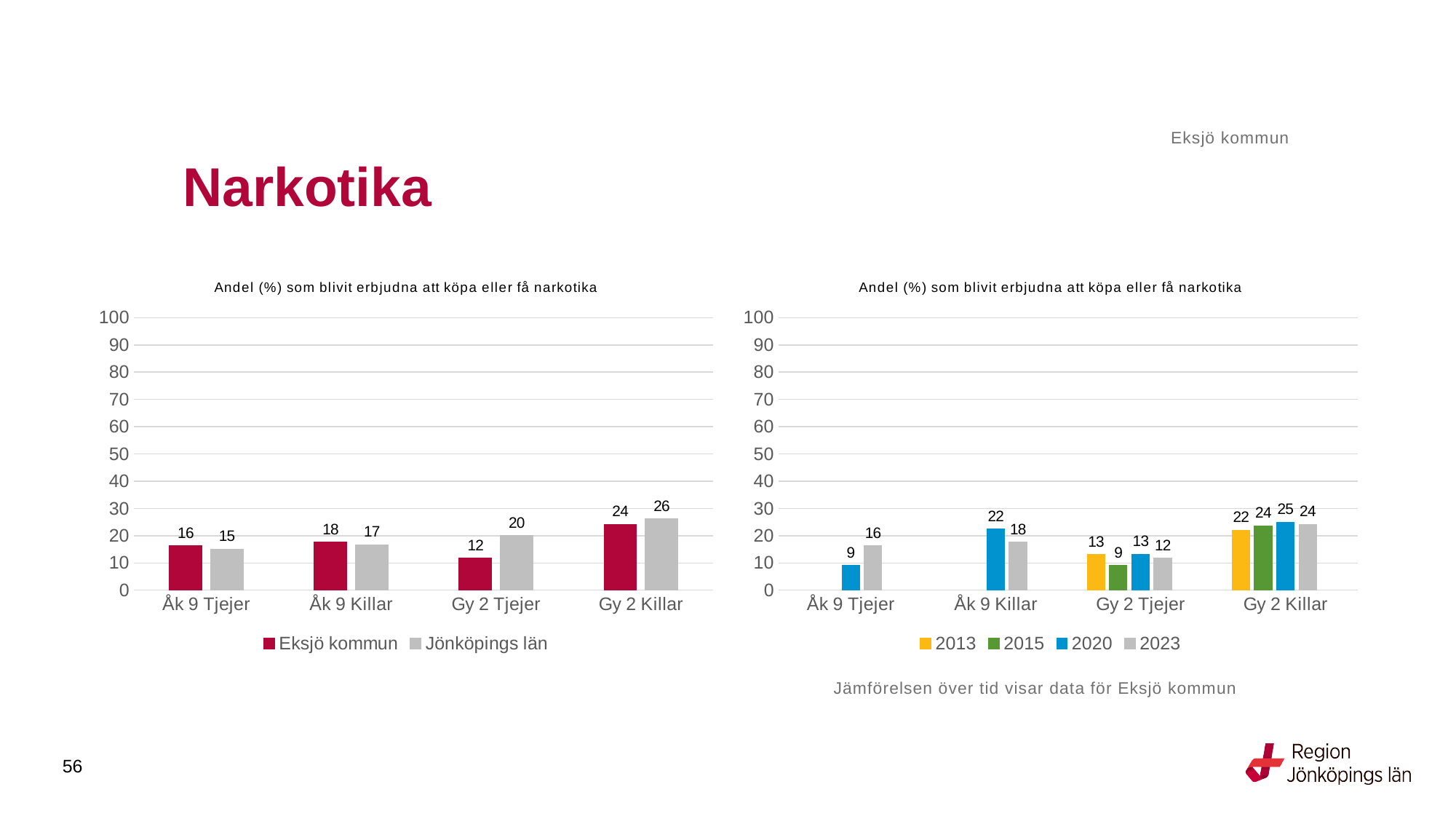
In the right chart, which year has the highest value for Gy 2 Killar? 2020 In the left chart, which category has the highest value for Eksjö kommun? Gy 2 Killar In the right chart, what is the difference between 2023 and 2020 for Åk 9 Tjejer? 7 In the left chart, what is the value for Eksjö kommun for Gy 2 Tjejer? 12 In the right chart, what is the value for 2020 for Åk 9 Killar? 22 In the right chart, what is the value for 2013 for Gy 2 Killar? 22 In the left chart, what is the difference between Jönköpings län and Eksjö kommun for Gy 2 Tjejer? 8 In the left chart, which is larger for Åk 9 Killar: Eksjö kommun or Jönköpings län? Eksjö kommun In the right chart, how many series does the legend list? 4 In the left chart, how many series does the legend list? 2 What kind of chart is the right chart? Bar chart In the left chart, what is the value for Jönköpings län for Gy 2 Killar? 26